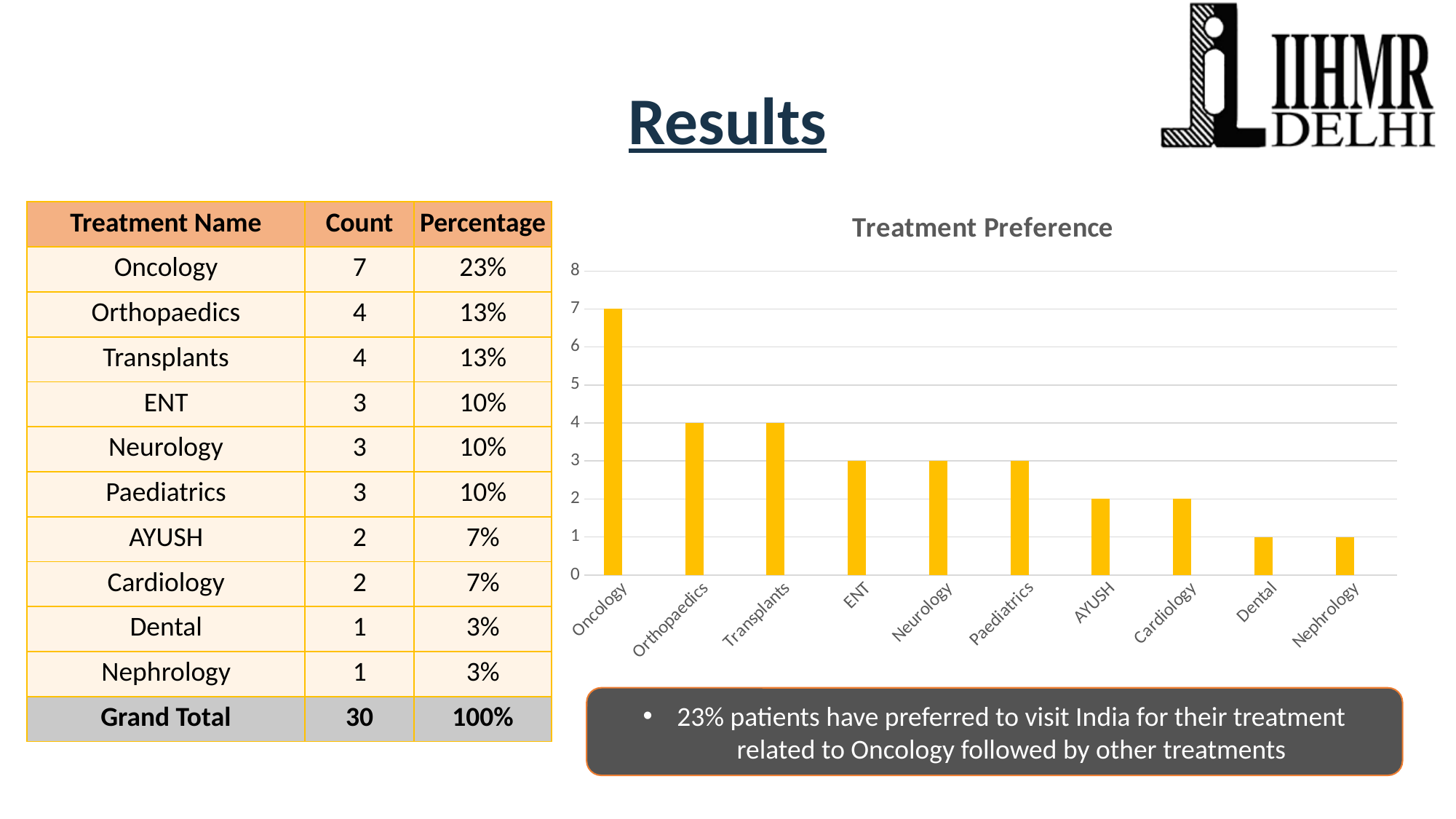
What is the difference between the bar values for Oncology and Orthopaedics? 3 What is the value of the bar for Nephrology? 1 Which bar is taller, ENT or Cardiology? ENT Which treatment has the highest bar in the chart? Oncology What is the value of the bar for Oncology? 7 What is the value of the bar for Transplants? 4 Do the bar values rise or fall moving from left to right along the x axis? Fall What is the title of the chart? Treatment Preference How many treatment categories are plotted on the x axis of the chart? 10 Is the value for Paediatrics greater or less than 4? less What type of chart is shown under the title "Treatment Preference"? Bar chart What is the value of the bar for AYUSH? 2